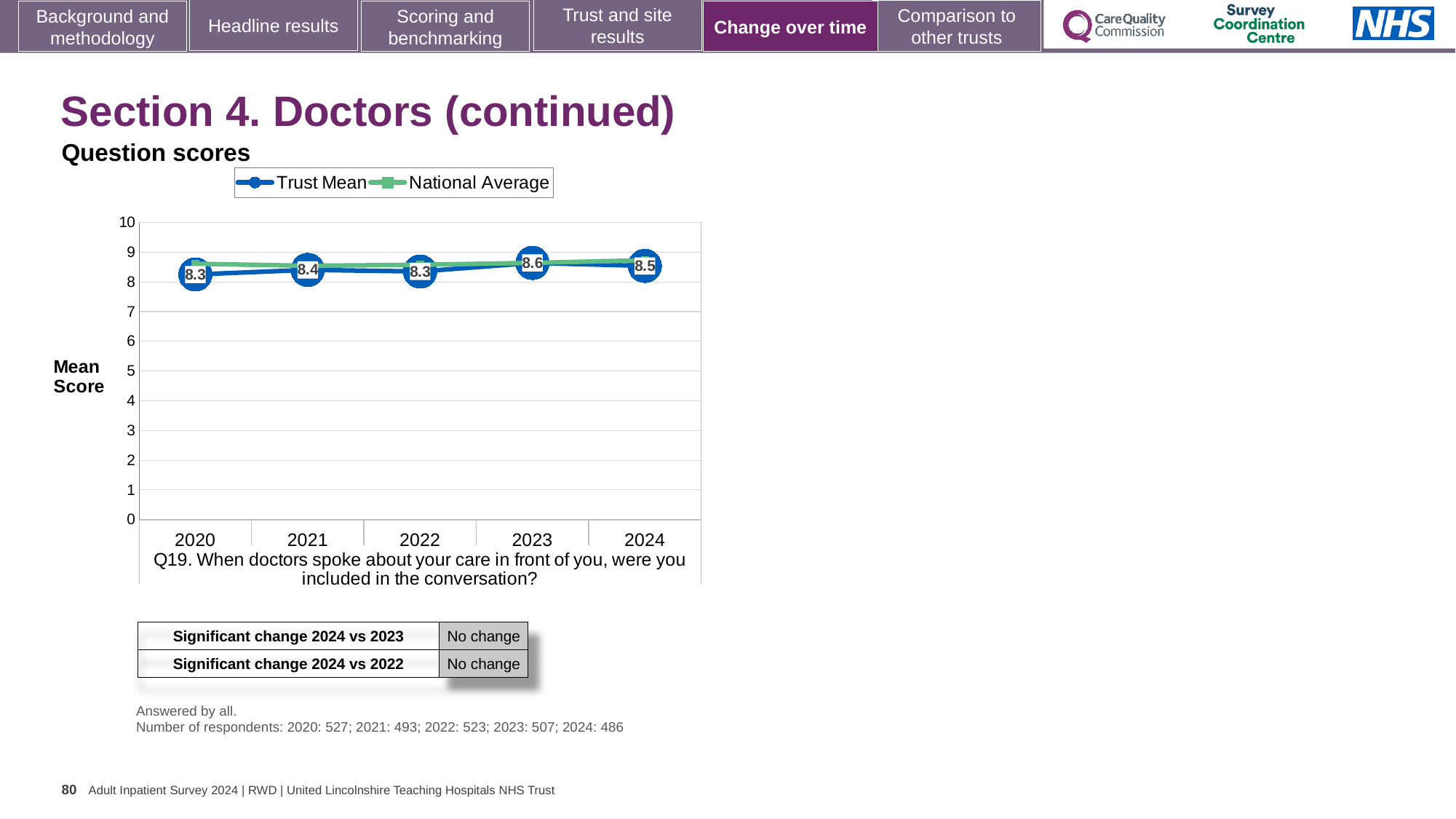
What is the Trust Mean score for 2020? 8.3 Which year has the larger Trust Mean score, 2021 or 2023? 2023 What is the difference between the Trust Mean scores for 2023 and 2020? 0.3 What kind of chart is shown on the slide? Line chart What are the two series named in the legend? Trust Mean and National Average Does the Trust Mean score rise or fall from 2022 to 2023? Rise In which year is the Trust Mean score highest? 2023 How many series does the legend list? 2 What is the Trust Mean score for 2023? 8.6 What is the Trust Mean score for 2024? 8.5 Is the National Average value for 2024 greater or less than 8? greater How many years are plotted on the x axis? 5